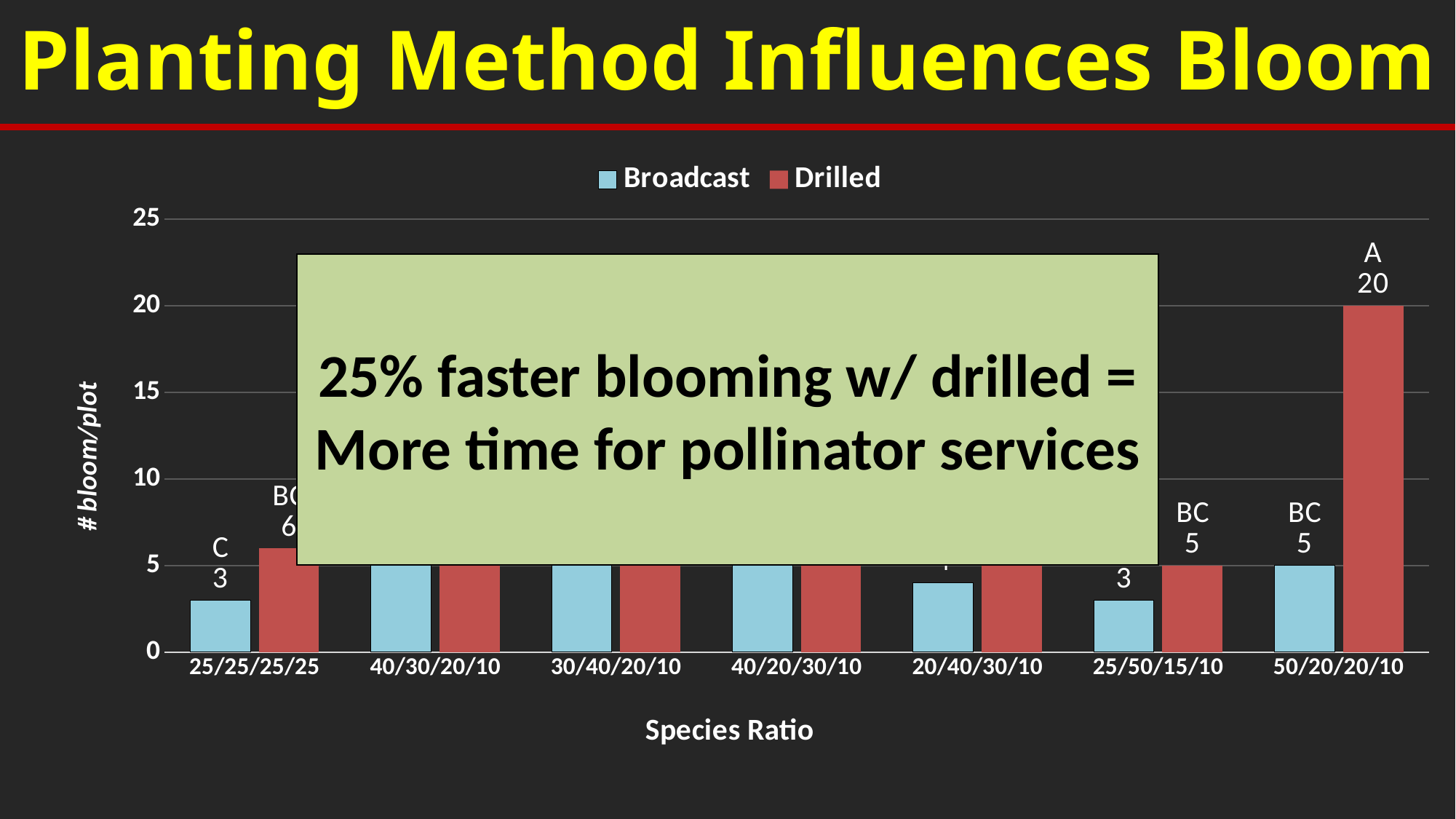
For the 25/50/15/10 species ratio, which is larger, the Broadcast or the Drilled value? Drilled What is the label on the y axis of the chart? # bloom/plot What is the Drilled value for the 50/20/20/10 species ratio? 20 What is the Broadcast value for the 50/20/20/10 species ratio? 5 What is the difference between the Drilled and Broadcast values for the 50/20/20/10 species ratio? 15 What is the Drilled value for the 25/50/15/10 species ratio? 5 Is the Broadcast value for the 40/30/20/10 species ratio greater or less than 10? less Which species ratio has the highest Drilled value? 50/20/20/10 How many series does the legend list? 2 What is the Broadcast value for the 25/25/25/25 species ratio? 3 How many species ratio categories are shown on the x axis? 7 What kind of chart is shown on the slide? bar chart